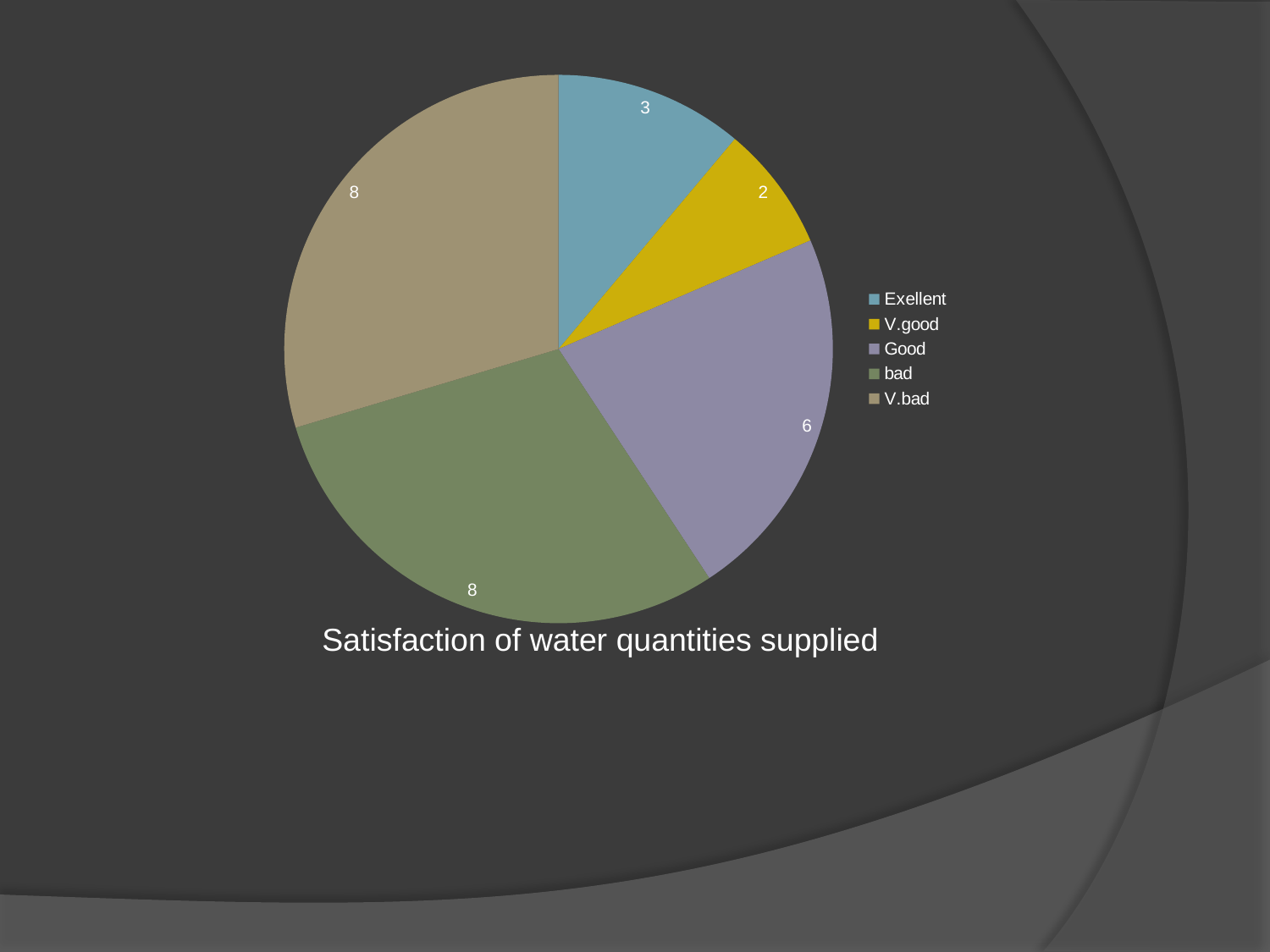
What is the difference between the values for Good and Exellent? 3 What is the value for Exellent in the pie chart? 3 What is the total of all the values shown in the pie chart? 27 What kind of chart is shown on the slide? Pie chart What is the value for V.good in the pie chart? 2 What is the title of the chart? Satisfaction of water quantities supplied How many categories does the pie chart show? 5 What is the value for Good in the pie chart? 6 What is the value for bad in the pie chart? 8 Which category has the smallest slice in the pie chart? V.good What is the difference between the values for bad and Good? 2 Which is larger, the value for Good or the value for V.good? Good